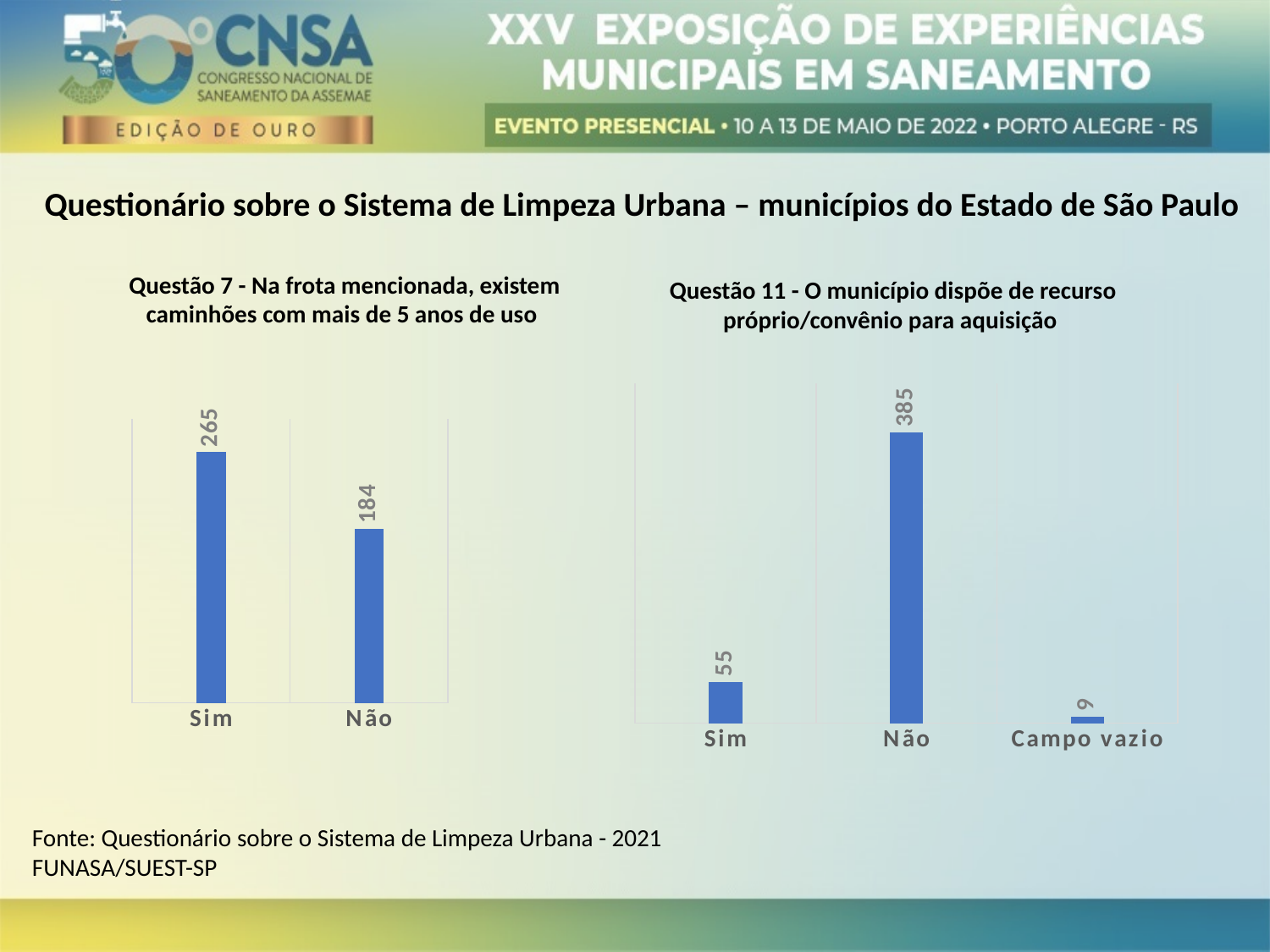
In the Questão 7 chart, what is the difference between the values for Sim and Não? 81 In the Questão 11 chart, what is the value for Sim? 55 What kind of chart is the Questão 11 chart? Bar chart In the Questão 11 chart, what is the value for Não? 385 In the Questão 7 chart, what is the value for Não? 184 In the Questão 11 chart, what is the value for Campo vazio? 9 In the Questão 11 chart, what is the difference between the values for Não and Sim? 330 In the Questão 7 chart, how many categories are shown? 2 In the Questão 7 chart, which category has the higher value, Sim or Não? Sim In the Questão 11 chart, which category has the highest value? Não In the Questão 11 chart, which category has the lowest value? Campo vazio In the Questão 7 chart, what is the value for Sim? 265